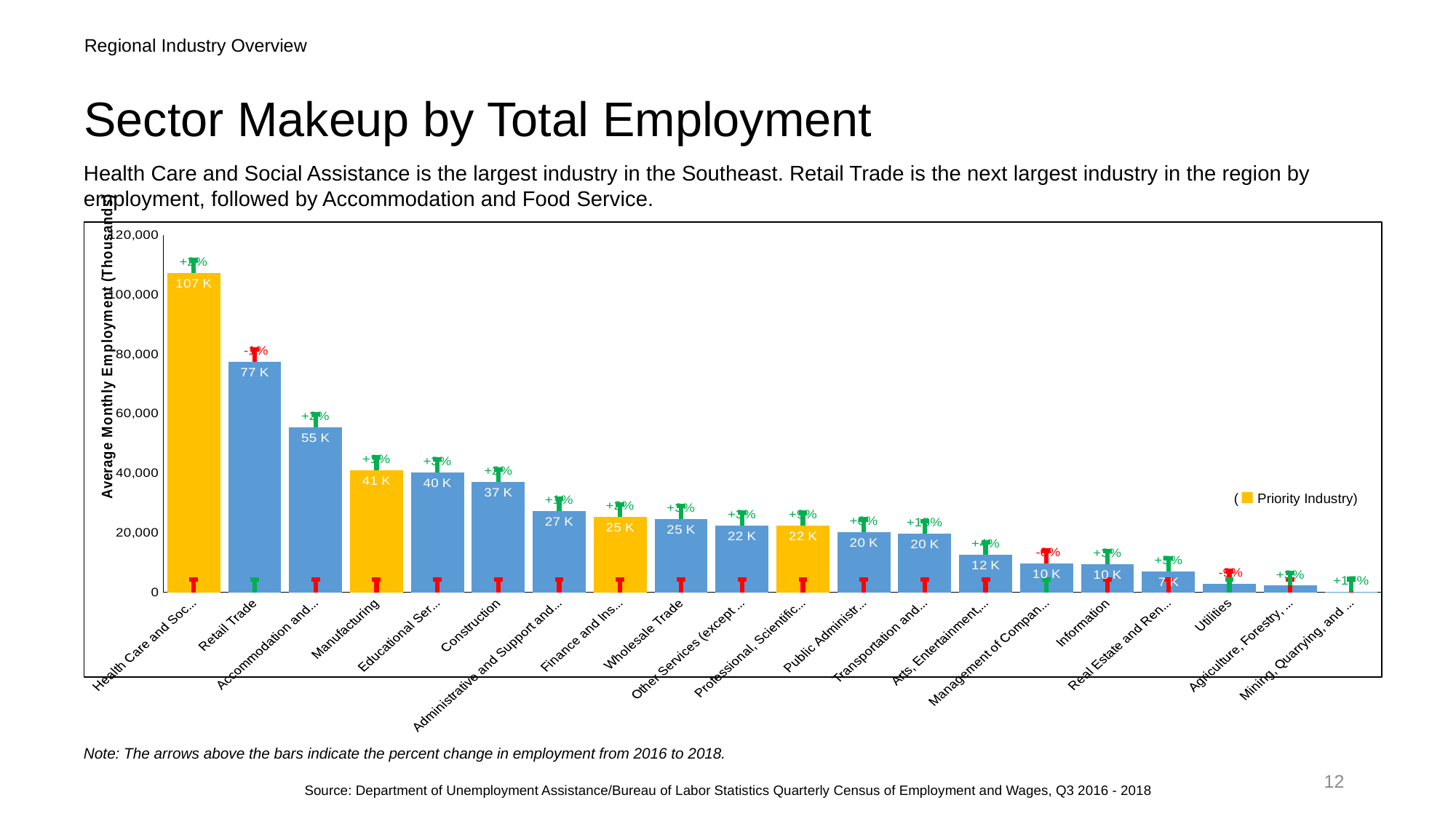
Is the value for Utilities greater or less than 20,000? less Which category has the highest average monthly employment? Health Care and Soc... What is the value for Retail Trade? 77 K What is the value for Construction? 37 K Do the bar values rise or fall from left to right along the x axis? fall What is the difference between the values for Health Care and Soc... and Retail Trade? 30 K Which is larger, the value for Retail Trade or the value for Construction? Retail Trade What is the value for Information? 10 K What is the value for Manufacturing? 41 K How many categories (bars) are shown in the chart? 20 What kind of chart is shown on the slide? bar chart What is the value for Wholesale Trade? 25 K